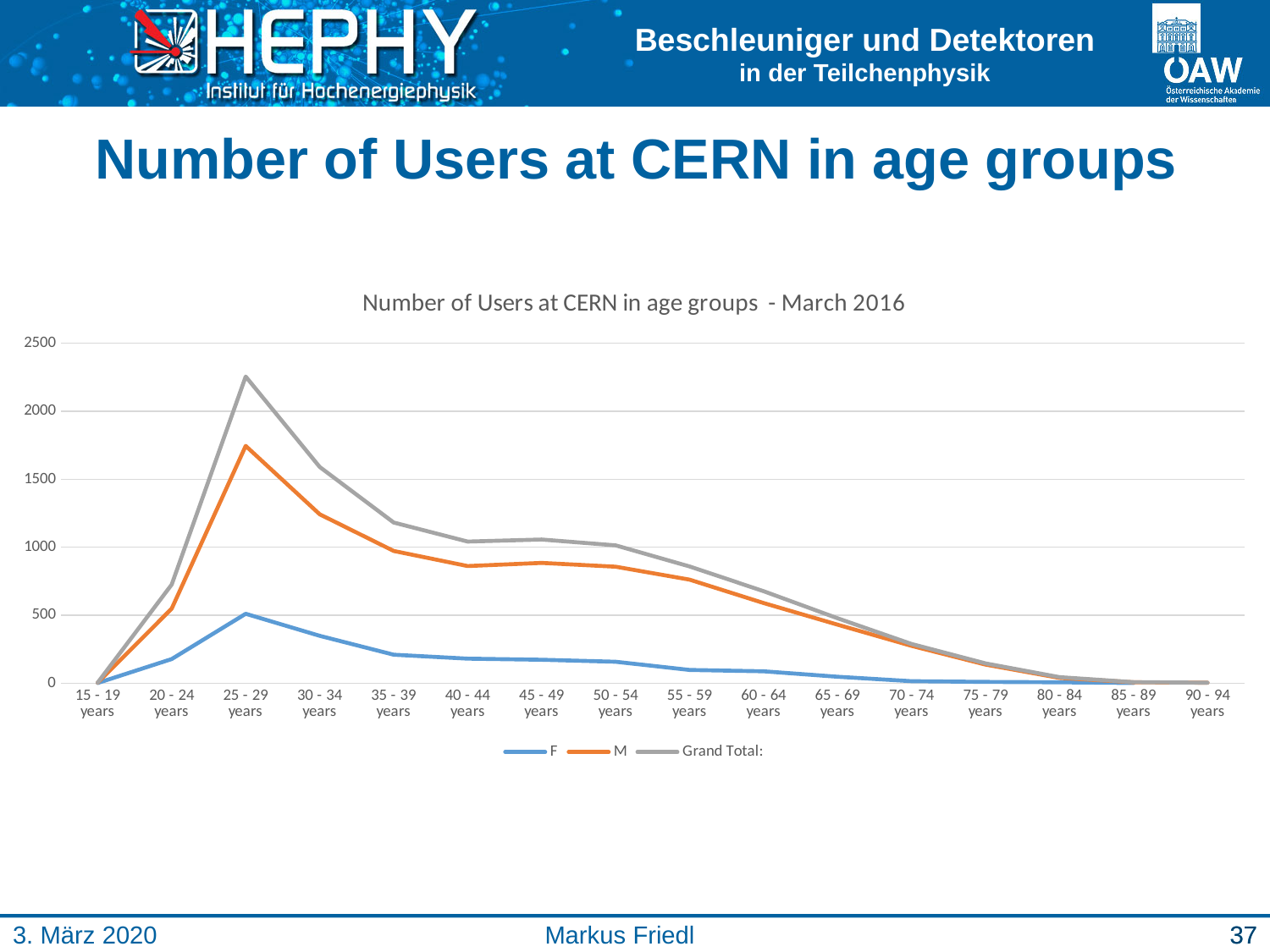
What kind of chart is shown on the slide? line chart What is the title of the chart? Number of Users at CERN in age groups - March 2016 Do the Grand Total values rise or fall along the x axis from 25 - 29 years to 90 - 94 years? fall Is the Grand Total value for 35 - 39 years greater or less than 1000? greater How many series does the legend list? 3 Is the Grand Total value for 25 - 29 years greater or less than 2000? greater Which age group has the highest Grand Total value? 25 - 29 years Is the M value for 40 - 44 years greater or less than 1000? less Which is larger for the 25 - 29 years group, the M value or the F value? M How many age groups are shown on the x axis? 16